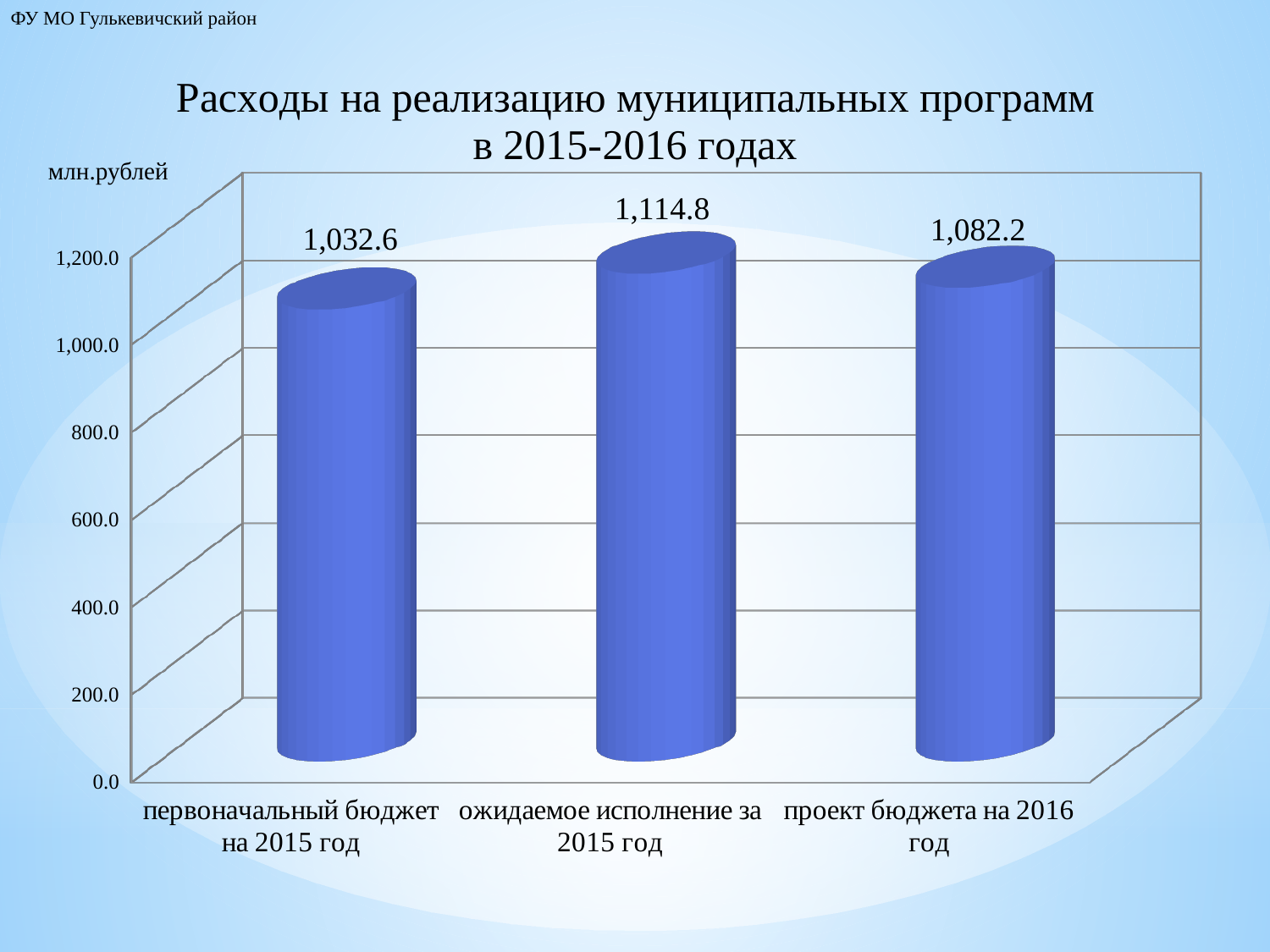
What is the value for 'проект бюджета на 2016 год'? 1,082.2 What is the value for 'первоначальный бюджет на 2015 год'? 1,032.6 How many categories are shown on the chart? 3 What unit is indicated for the values on the chart? млн.рублей Which category has the lowest value? первоначальный бюджет на 2015 год What is the value for 'ожидаемое исполнение за 2015 год'? 1,114.8 Is the value for 'первоначальный бюджет на 2015 год' greater or less than 1,000.0? greater What is the difference between 'ожидаемое исполнение за 2015 год' and 'первоначальный бюджет на 2015 год'? 82.2 Which category has the highest value? ожидаемое исполнение за 2015 год Which is larger: 'проект бюджета на 2016 год' or 'первоначальный бюджет на 2015 год'? проект бюджета на 2016 год What kind of chart is shown on the slide? bar chart What is the difference between 'ожидаемое исполнение за 2015 год' and 'проект бюджета на 2016 год'? 32.6